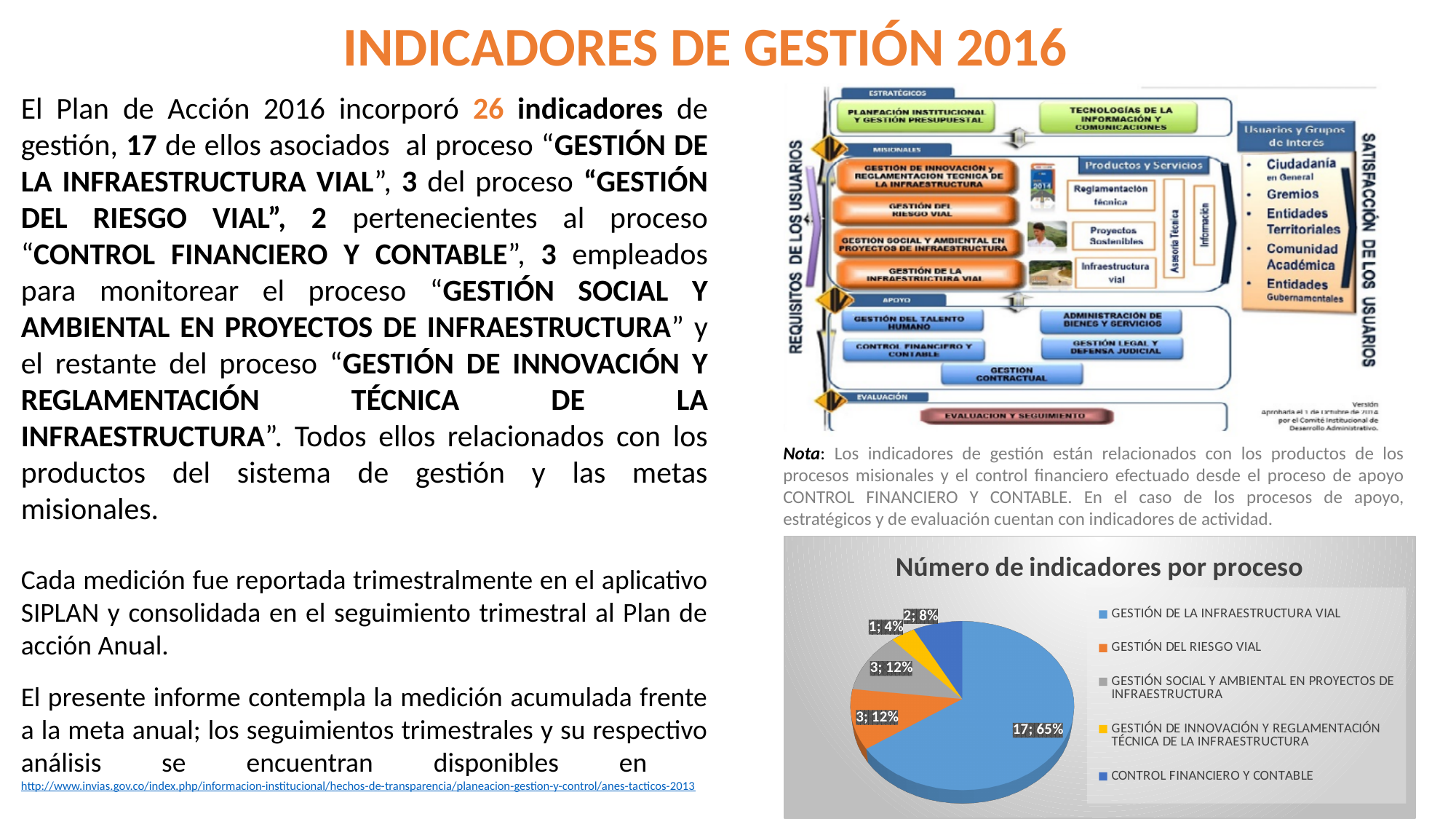
In the pie chart "Número de indicadores por proceso", how many indicators does GESTIÓN DE LA INFRAESTRUCTURA VIAL have? 17 In the pie chart "Número de indicadores por proceso", which has more indicators: CONTROL FINANCIERO Y CONTABLE or GESTIÓN SOCIAL Y AMBIENTAL EN PROYECTOS DE INFRAESTRUCTURA? GESTIÓN SOCIAL Y AMBIENTAL EN PROYECTOS DE INFRAESTRUCTURA In the pie chart "Número de indicadores por proceso", what is the total number of indicators across all slices? 26 What kind of chart is "Número de indicadores por proceso"? pie chart In the pie chart "Número de indicadores por proceso", which process is shown in orange? GESTIÓN DEL RIESGO VIAL In the pie chart "Número de indicadores por proceso", how many indicators does CONTROL FINANCIERO Y CONTABLE have? 2 In the pie chart "Número de indicadores por proceso", which process has the fewest indicators? GESTIÓN DE INNOVACIÓN Y REGLAMENTACIÓN TÉCNICA DE LA INFRAESTRUCTURA How many slices does the pie chart "Número de indicadores por proceso" have? 5 In the pie chart "Número de indicadores por proceso", what percentage is shown for GESTIÓN DE INNOVACIÓN Y REGLAMENTACIÓN TÉCNICA DE LA INFRAESTRUCTURA? 4% In the pie chart "Número de indicadores por proceso", what share of the pie does GESTIÓN DE LA INFRAESTRUCTURA VIAL represent? 65% In the pie chart "Número de indicadores por proceso", which process has the most indicators? GESTIÓN DE LA INFRAESTRUCTURA VIAL In the pie chart "Número de indicadores por proceso", how many more indicators does GESTIÓN DE LA INFRAESTRUCTURA VIAL have than GESTIÓN DEL RIESGO VIAL? 14